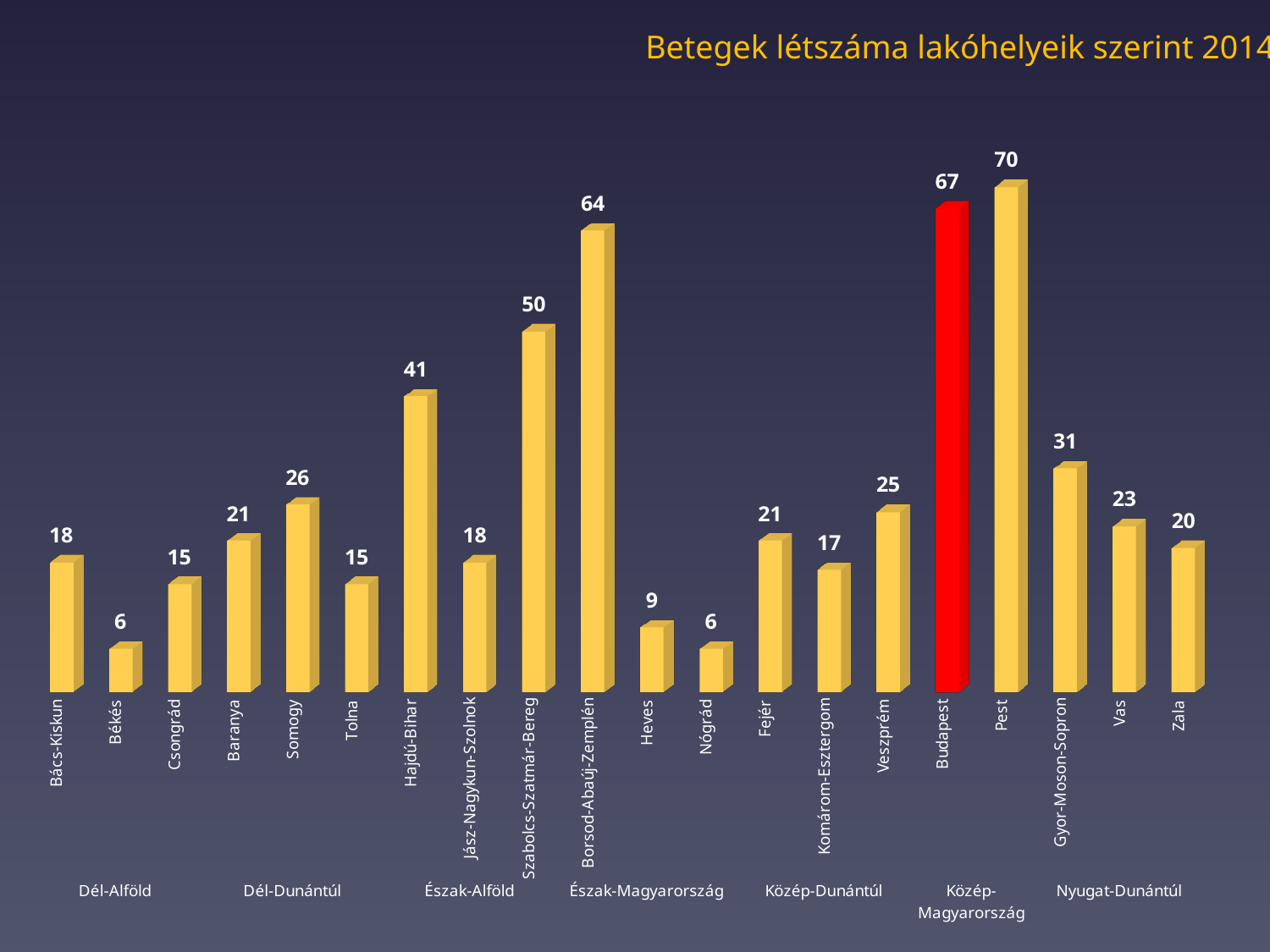
Which bar is coloured red instead of yellow? Budapest What is the value for Veszprém? 25 What is the difference between the values for Borsod-Abaúj-Zemplén and Szabolcs-Szatmár-Bereg? 14 Which category has the highest value? Pest What is the difference between the values for Pest and Budapest? 3 What is the value for Borsod-Abaúj-Zemplén? 64 What is the value for Heves? 9 How many counties (bars) are shown on the chart? 20 What kind of chart is shown on the slide? Bar chart What is the value for Budapest? 67 Which is larger, the value for Hajdú-Bihar or the value for Gyor-Moson-Sopron? Hajdú-Bihar What is the lowest value shown on the chart? 6